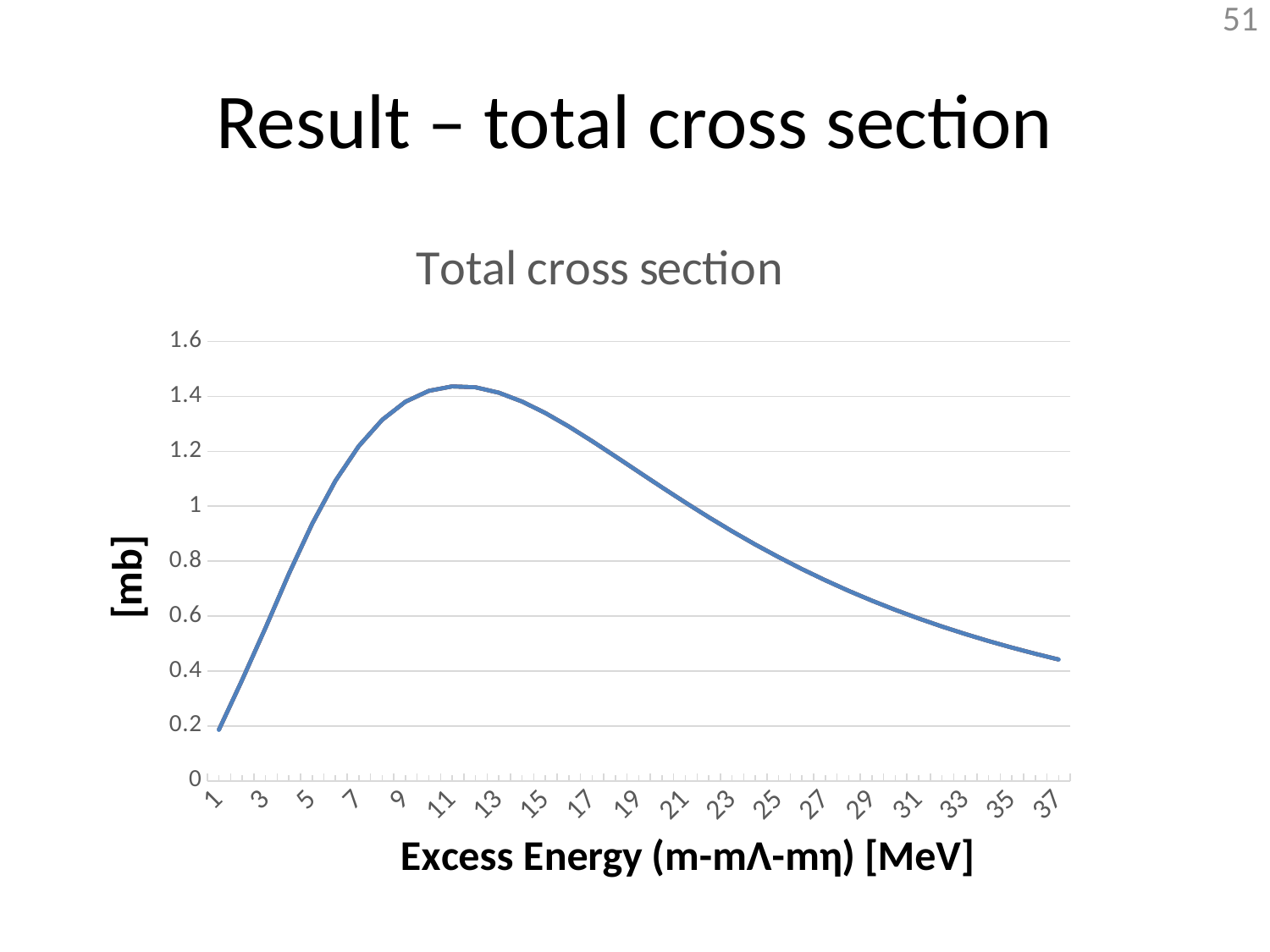
Is the value at excess energy 37 greater or less than 0.4? greater Is the value at excess energy 15 greater or less than 1.2? greater Which is larger, the value at excess energy 1 or at excess energy 37? 37 Is the value at excess energy 3 greater or less than 0.8? less What kind of chart is shown on the slide? line chart What is the title of the chart? Total cross section Which is larger, the value at excess energy 9 or at excess energy 29? 9 Does the total cross section rise or fall as excess energy increases from 15 to 37? fall What is the label of the y axis? [mb]